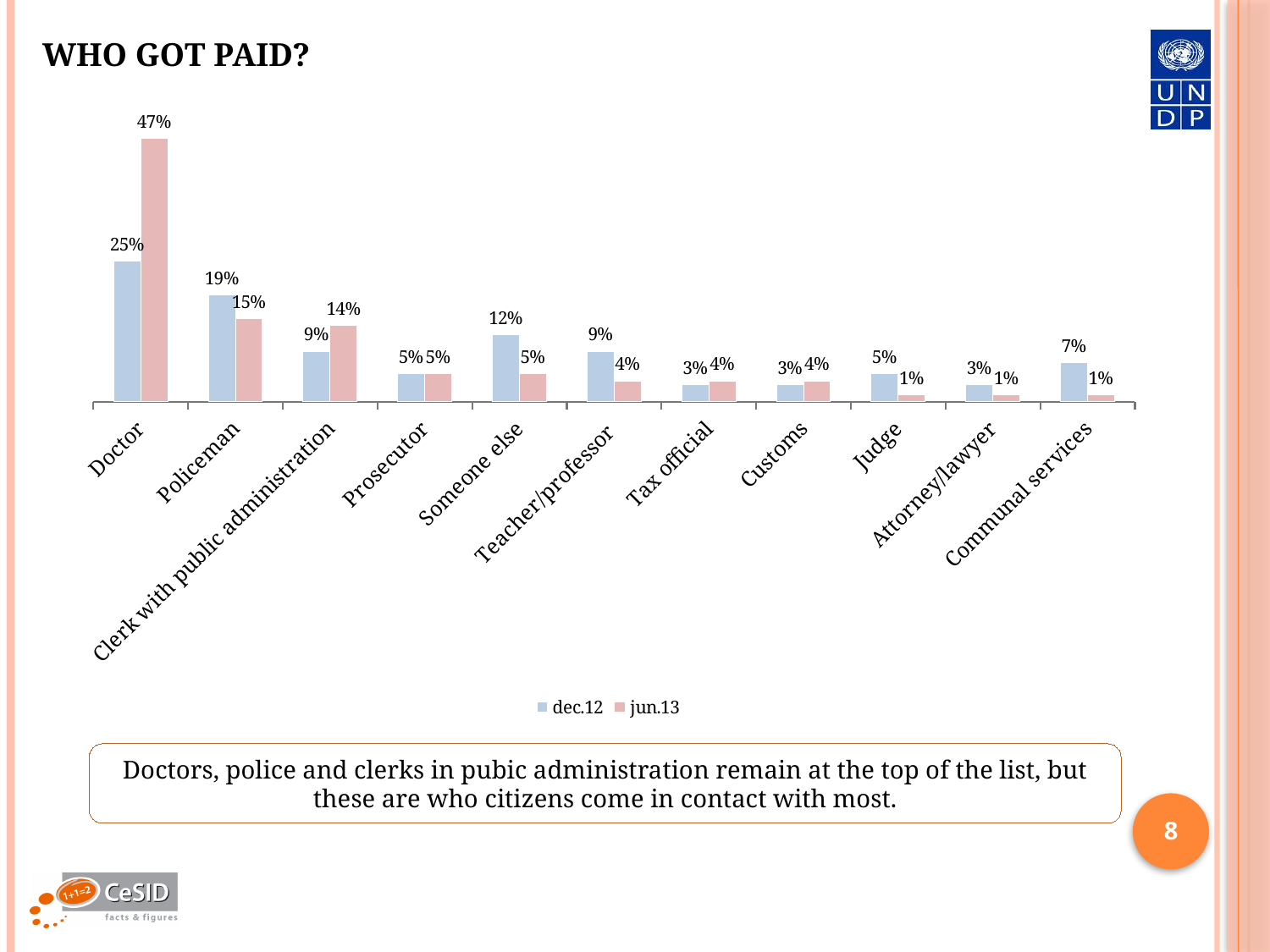
Which is larger for Communal services, the dec.12 value or the jun.13 value? dec.12 How many series does the legend list? 2 How many categories are shown on the x axis? 11 What kind of chart is shown on the slide? Bar chart What is the difference between the jun.13 and dec.12 values for Doctor? 22% What is the dec.12 value for Someone else? 12% Which category has the lowest dec.12 value? Tax official, Customs and Attorney/lawyer (3%) What is the jun.13 value for Doctor? 47% What is the dec.12 value for Policeman? 19% What are the two series named in the legend? dec.12 and jun.13 Which category has the highest jun.13 value? Doctor What is the jun.13 value for Clerk with public administration? 14%